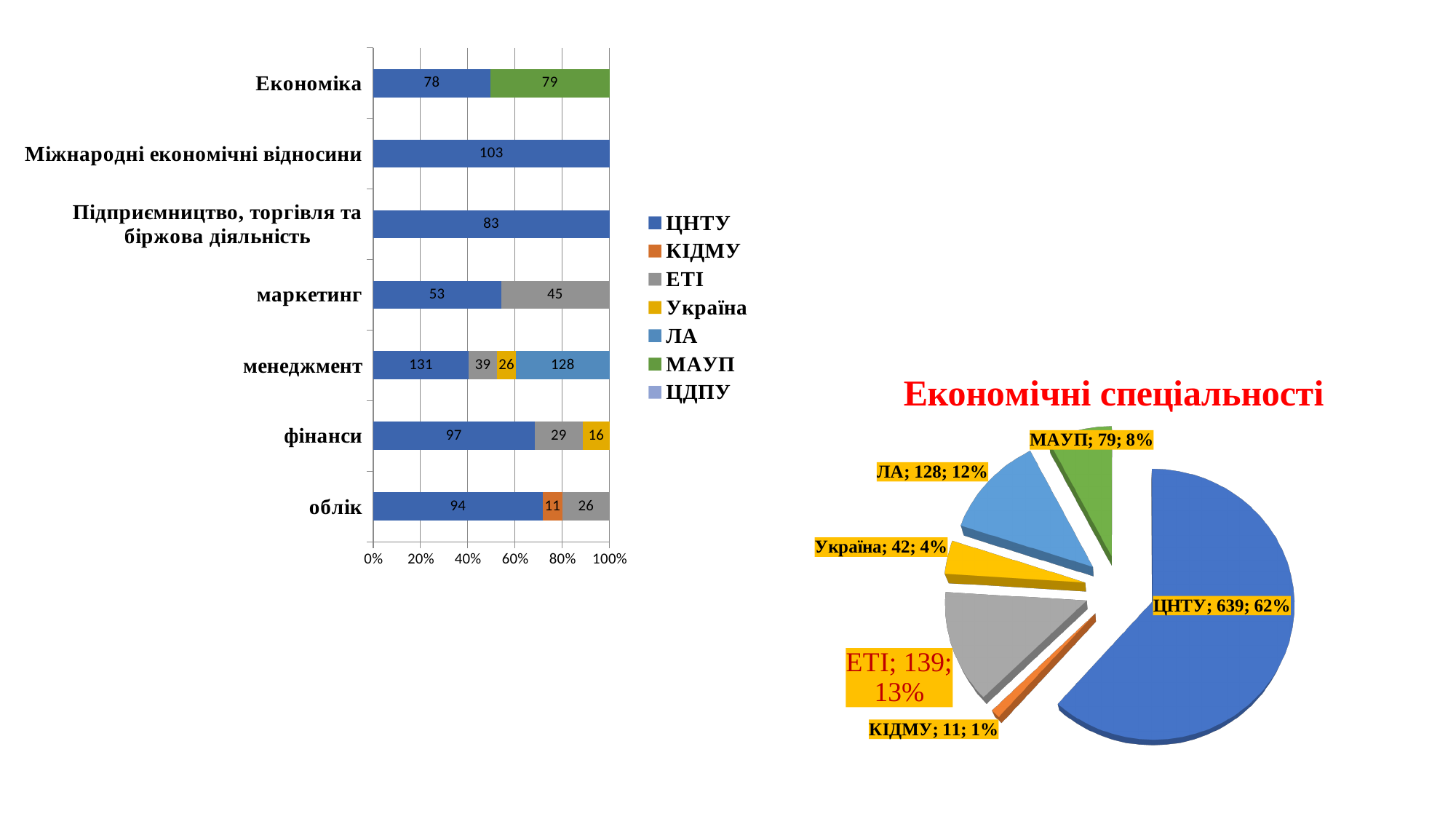
In the bar chart on the left, which is larger: the ЦНТУ value for фінанси or the ЦНТУ value for облік? фінанси In the bar chart on the left, how many series does the legend list? 7 In the pie chart 'Економічні спеціальності', what share does ЕТІ have? 13% What kind of chart is the chart titled 'Економічні спеціальності'? pie chart In the bar chart on the left, what is the value for КІДМУ in the облік category? 11 In the bar chart on the left, what is the difference between the ЦНТУ value for Міжнародні економічні відносини and the ЦНТУ value for Підприємництво, торгівля та біржова діяльність? 20 In the pie chart 'Економічні спеціальності', what is the value for ЛА? 128 In the bar chart on the left, what is the value for ЦНТУ in the менеджмент category? 131 In the bar chart on the left, what is the total of the менеджмент bar? 324 In the bar chart on the left, what is the value for ЕТІ in the маркетинг category? 45 In the bar chart on the left, how many categories are shown on the vertical axis? 7 In the pie chart 'Економічні спеціальності', which slice is the largest? ЦНТУ